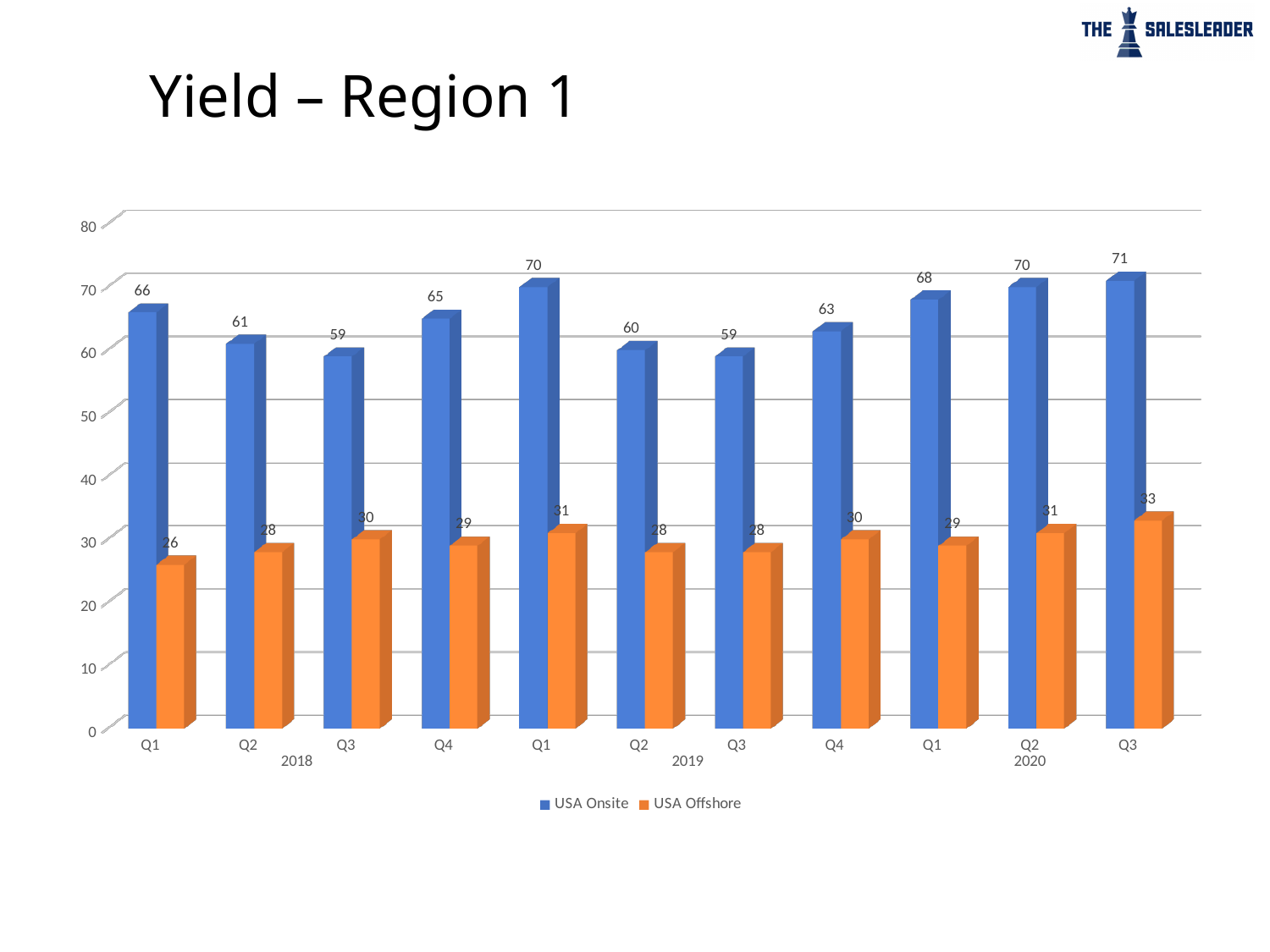
Which is larger, the USA Onsite value for Q2 2018 or for Q4 2018? Q4 2018 What is the USA Offshore value for Q3 2020? 33 What is the USA Onsite value for Q4 2019? 63 What is the difference between the USA Onsite and USA Offshore values in Q1 2019? 39 Is the USA Offshore value for Q1 2018 greater or less than 30? less What is the title of the slide? Yield – Region 1 What kind of chart is shown on the slide? Bar chart Which quarter has the lowest USA Offshore value? Q1 2018 How many series does the legend list? 2 How many quarters are shown on the x axis? 11 What is the USA Onsite value for Q1 2018? 66 Which quarter has the highest USA Onsite value? Q3 2020